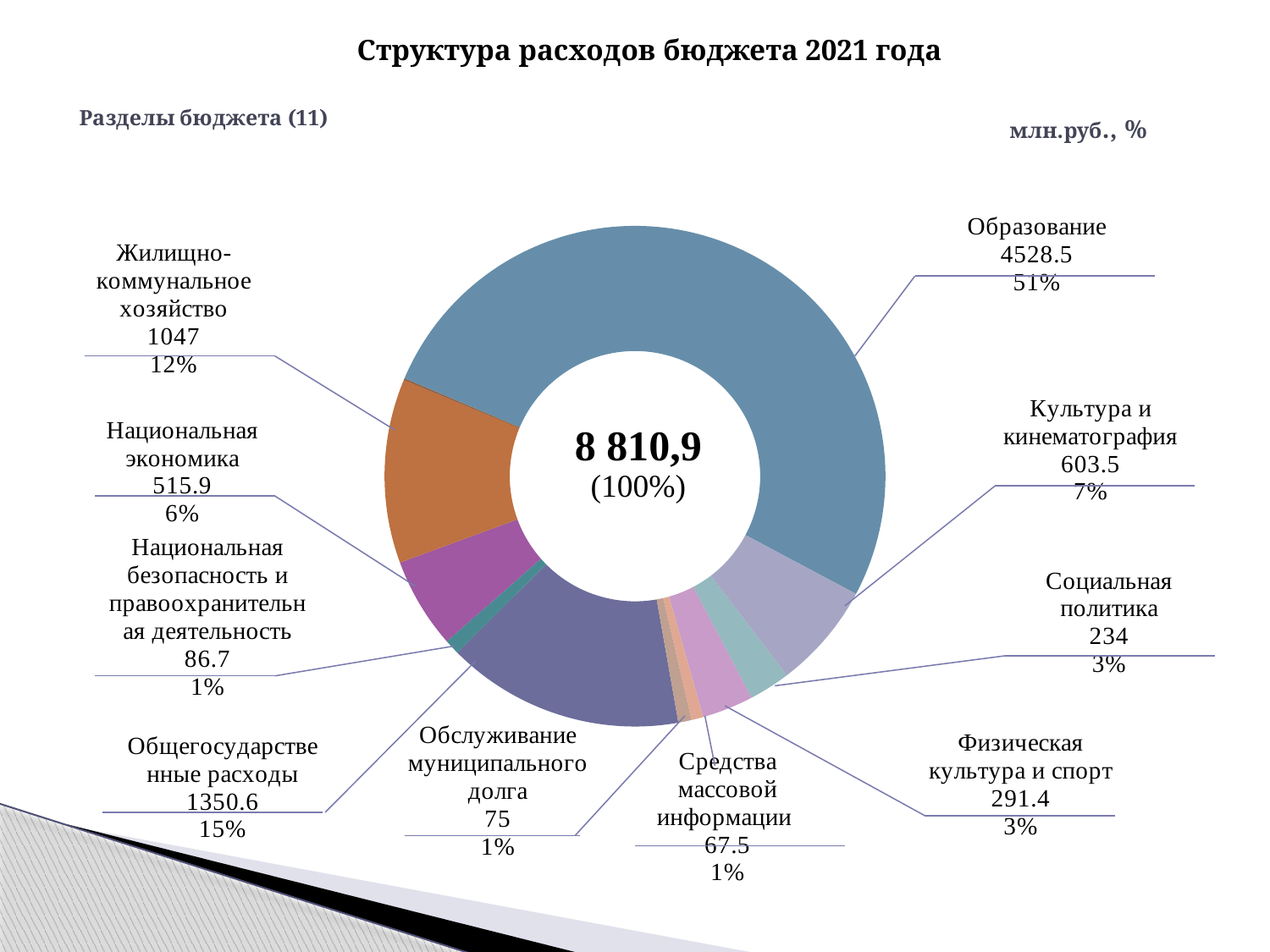
Which is larger: Культура и кинематография or Национальная экономика? Культура и кинематография What is the title of the chart? Разделы бюджета (11) What is the value for Образование? 4528.5 What type of chart is shown on the slide? doughnut (pie) chart What is the value for Физическая культура и спорт? 291.4 Which budget section has the largest share? Образование What share of the budget does Образование account for? 51% What is the value for Жилищно-коммунальное хозяйство? 1047 What total value is shown in the centre of the chart? 8 810,9 What percentage is shown for Общегосударственные расходы? 15% What is the difference between the values for Общегосударственные расходы and Жилищно-коммунальное хозяйство? 303.6